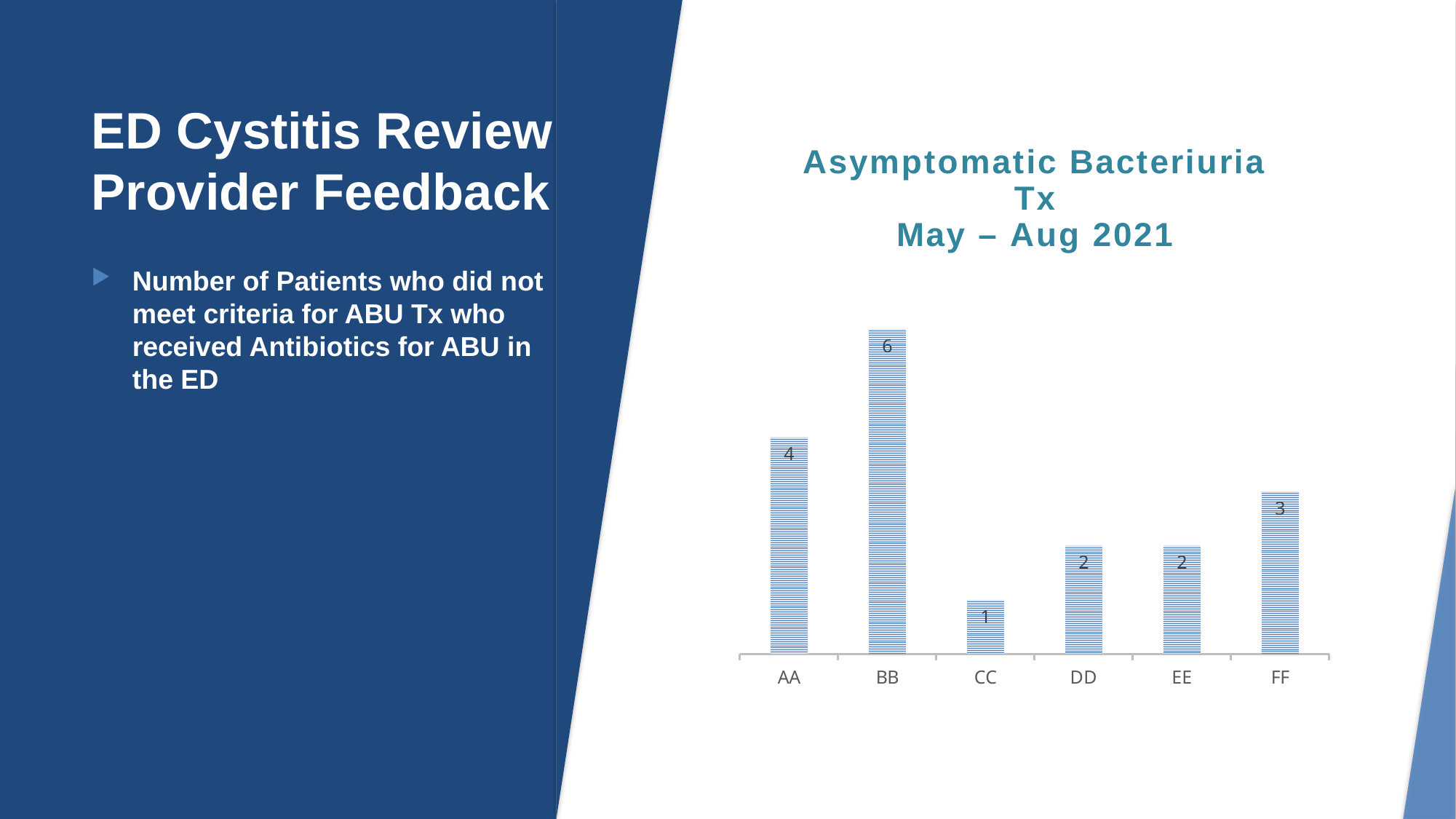
What is the value for BB? 6 Which category has the highest value? BB What is the title of the chart? Asymptomatic Bacteriuria Tx May – Aug 2021 What is the value for FF? 3 What is the value for CC? 1 Which category has the lowest value? CC What is the value for AA? 4 What is the difference between the values for BB and AA? 2 What kind of chart is shown on the slide? Bar chart Which is larger, the value for AA or the value for FF? AA How many categories are shown on the x axis? 6 What is the difference between the values for FF and CC? 2